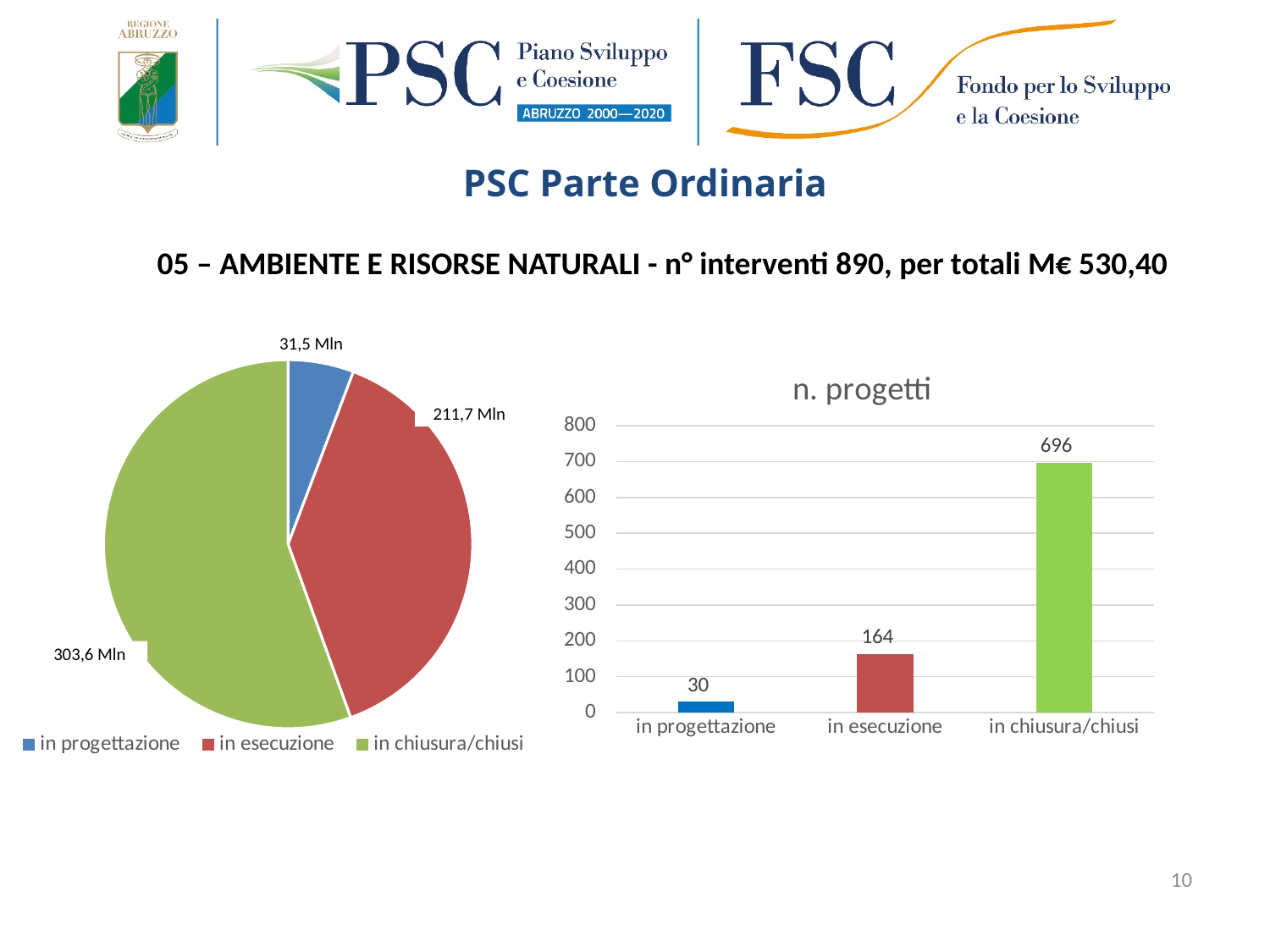
In the bar chart titled 'n. progetti', what is the value for 'in progettazione'? 30 In the pie chart on the left, which is larger: 'in progettazione' or 'in esecuzione'? in esecuzione In the bar chart titled 'n. progetti', what is the difference between 'in chiusura/chiusi' and 'in esecuzione'? 532 What kind of chart is the chart on the right of the slide? bar chart In the bar chart titled 'n. progetti', how many categories are shown on the x axis? 3 In the bar chart titled 'n. progetti', what is the value for 'in chiusura/chiusi'? 696 In the pie chart on the left, what is the difference between 'in chiusura/chiusi' and 'in esecuzione'? 91,9 Mln In the bar chart titled 'n. progetti', which category has the lowest value? in progettazione How many entries does the legend of the pie chart on the left list? 3 In the bar chart titled 'n. progetti', is the value for 'in esecuzione' greater or less than 200? less In the pie chart on the left, which category has the largest slice? in chiusura/chiusi In the pie chart on the left, what is the value for 'in esecuzione'? 211,7 Mln